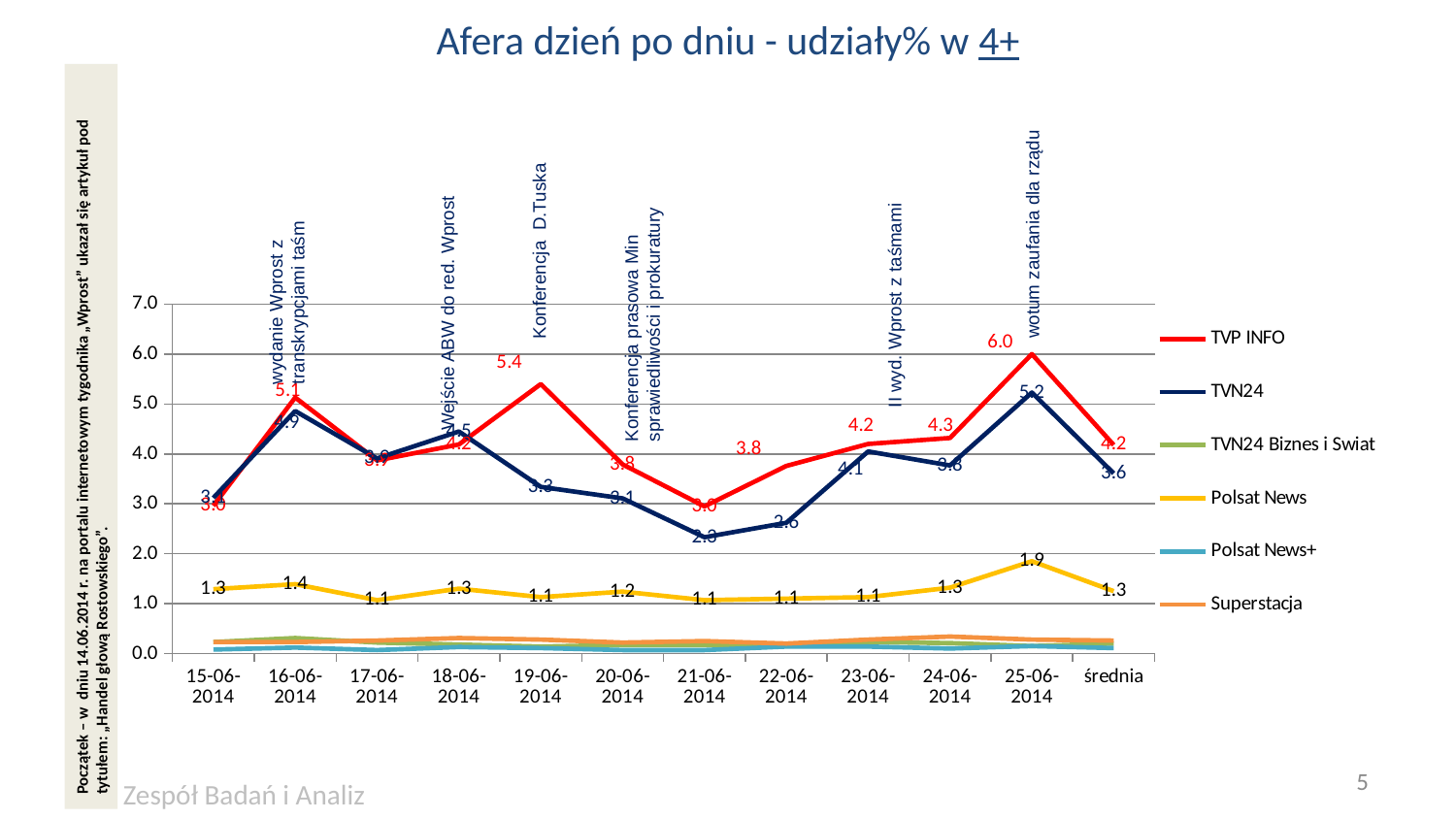
What is the value for TVP INFO on 19-06-2014? 5.4 What is the value for Polsat News on 25-06-2014? 1.9 On which date does TVP INFO reach its highest value? 25-06-2014 What is the średnia (average) value for TVN24? 3.6 What type of chart is shown on the slide? line chart Which series has the higher value on 19-06-2014, TVP INFO or TVN24? TVP INFO What is the value for TVP INFO on 25-06-2014? 6.0 How many categories are shown on the x axis? 12 How many series does the legend list? 6 What is the difference between TVP INFO and TVN24 on 25-06-2014? 0.8 Is the value for TVN24 on 21-06-2014 greater or less than 3.0? less Which series is drawn with the red line? TVP INFO